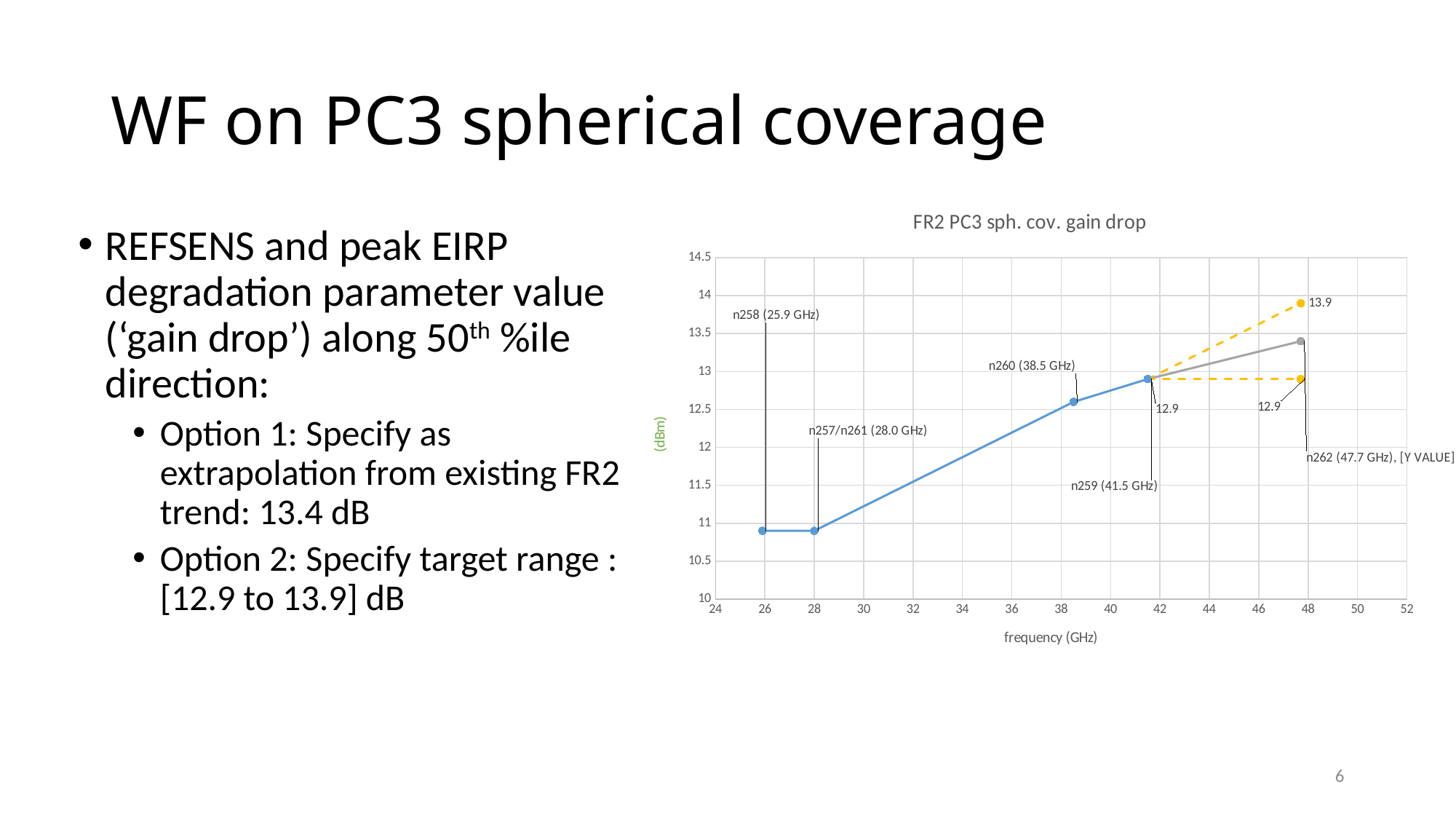
What is the difference between the upper and lower yellow points at 47.7 GHz? 1.0 What is the title of the chart? FR2 PC3 sph. cov. gain drop Is the value for n258 (25.9 GHz) greater or less than 12? less Which has the larger value, n260 (38.5 GHz) or n259 (41.5 GHz)? n259 (41.5 GHz) Do the plotted values rise or fall as frequency increases? rise What is the value of the lower yellow point at 47.7 GHz? 12.9 What is the label of the x axis? frequency (GHz) What kind of chart is shown on the slide? line chart At which frequency is the highest plotted value on the chart? 47.7 GHz What is the value of the upper yellow point at 47.7 GHz? 13.9 Is the value for n260 (38.5 GHz) greater or less than 12? greater What value is labelled for n259 (41.5 GHz)? 12.9